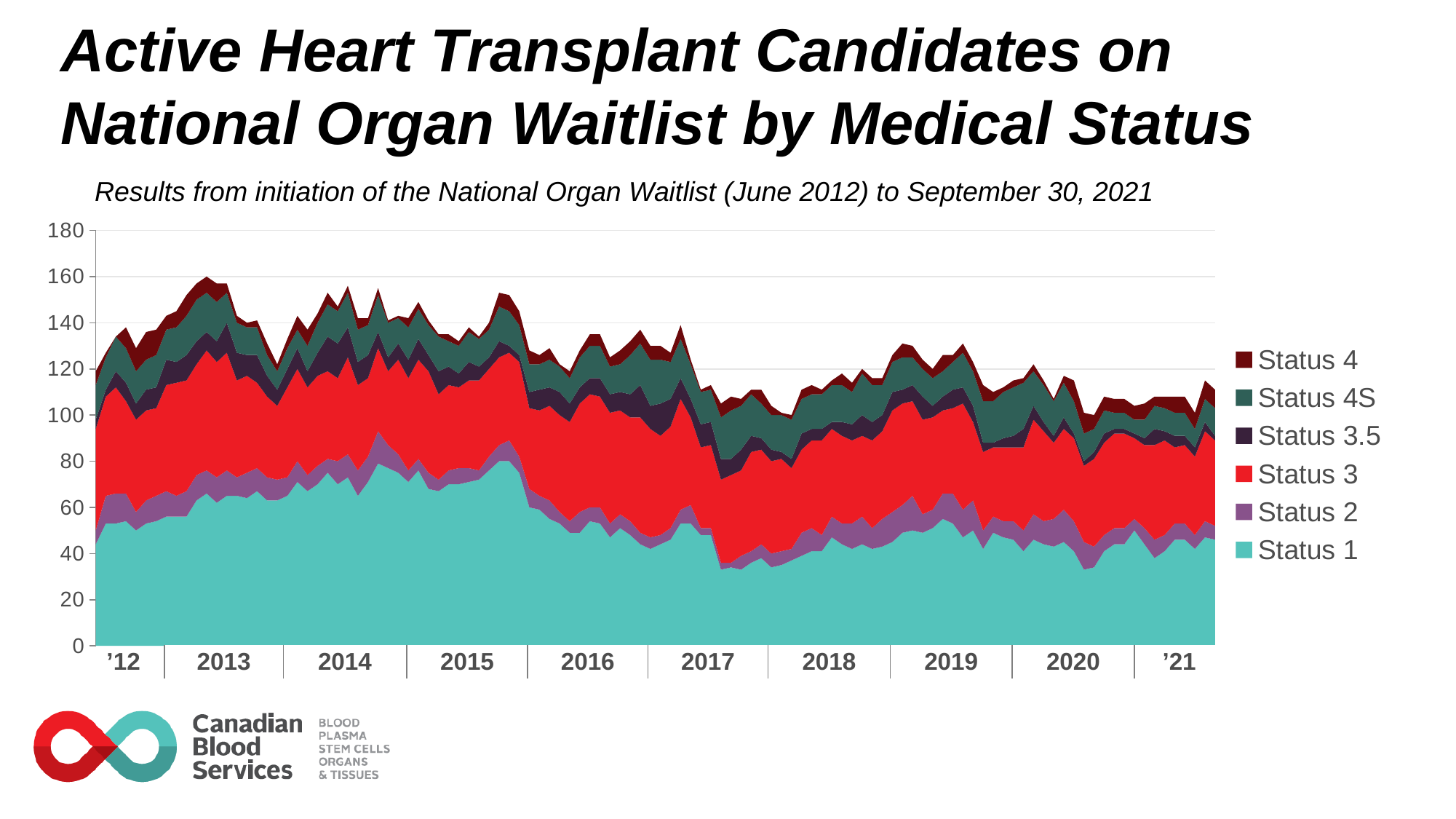
Is the total number of active heart transplant candidates at the 2013 peak greater or less than 180? less Is the total number of active heart transplant candidates at the 2013 peak greater or less than 140? greater Which series is plotted at the bottom of the stack? Status 1 What is the highest value shown on the vertical axis? 180 Is the value for Status 1 in mid-2017 greater or less than 60? less Does the total number of active heart transplant candidates rise or fall from 2013 to 2021? fall How many series does the legend list? 6 Does the value for Status 1 rise or fall from 2015 to 2017? fall Which series is plotted at the top of the stack? Status 4 What kind of chart is shown on the slide? Stacked area chart